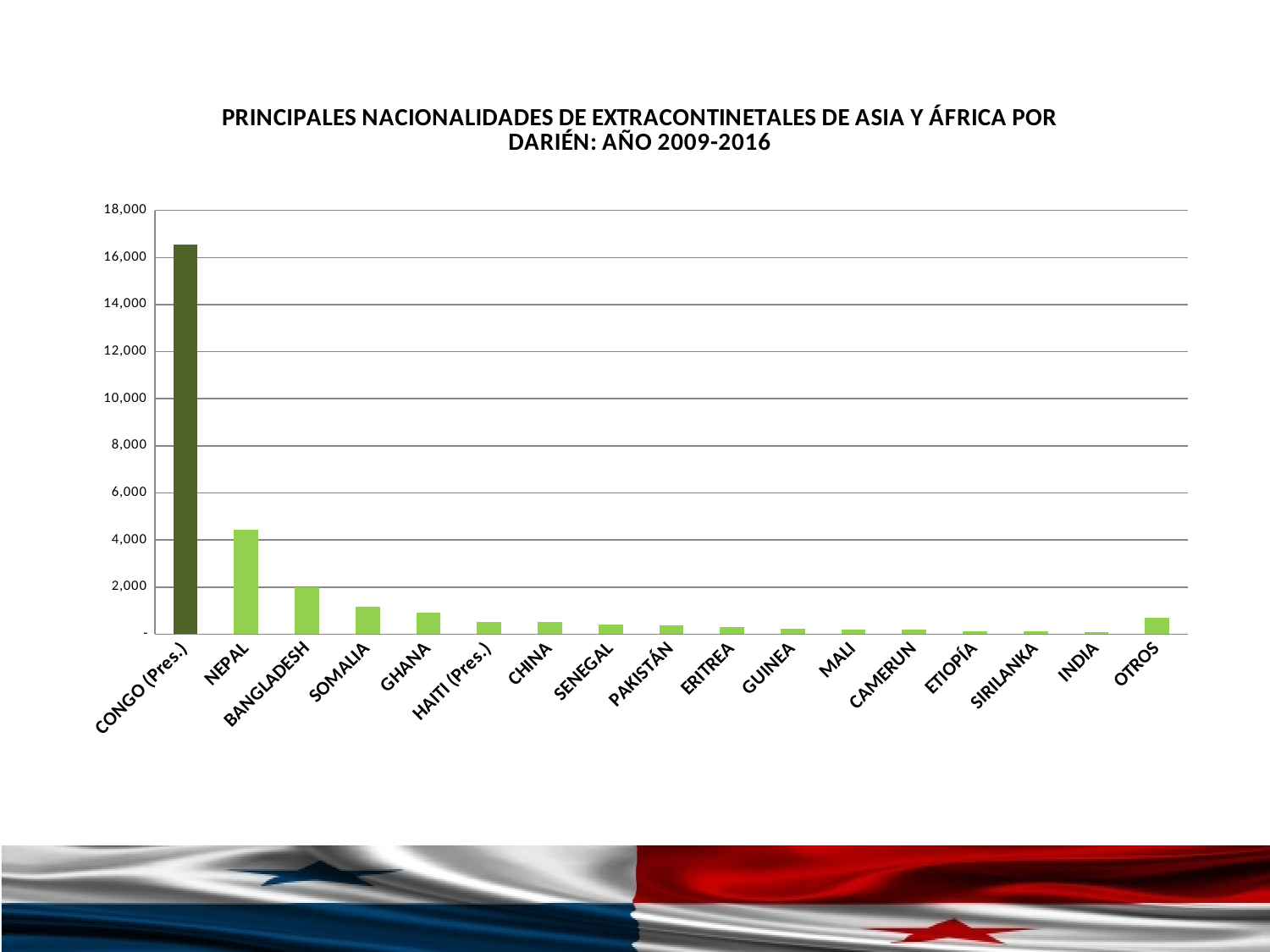
Is the value for OTROS greater or less than 2,000? less Is the value for SOMALIA greater or less than 2,000? less Which bar is drawn in a darker green than the others? CONGO (Pres.) Which category has the highest value? CONGO (Pres.) Is the value for CONGO (Pres.) greater or less than 16,000? greater How many nationality categories are shown on the x axis? 17 Which is larger, the value for NEPAL or the value for BANGLADESH? NEPAL Which is larger, the value for SOMALIA or the value for GHANA? SOMALIA What kind of chart is shown on the slide? Bar chart Do the values generally rise or fall along the x axis from CONGO (Pres.) to INDIA? fall Which category has the lowest value? INDIA